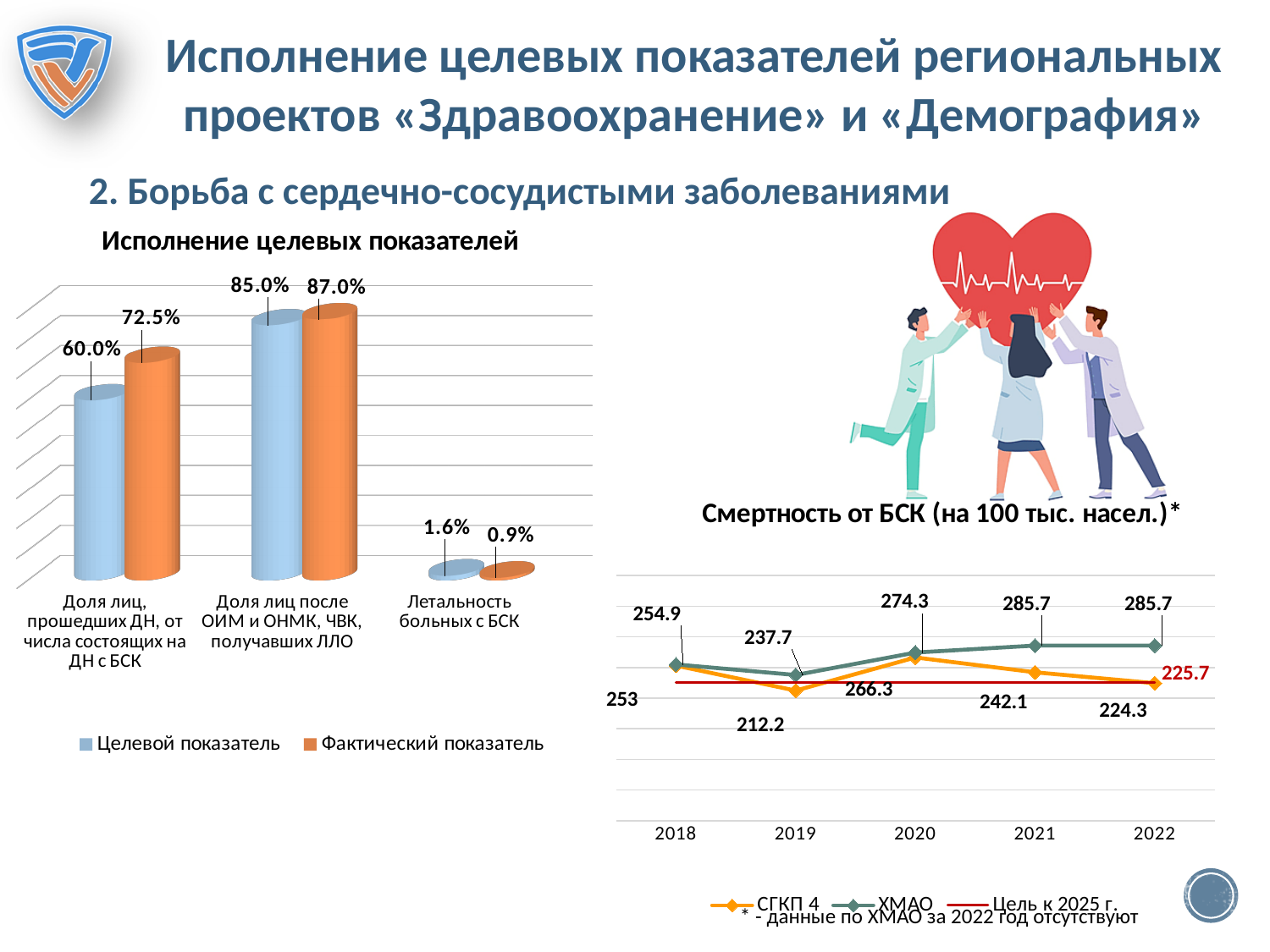
In the 'Смертность от БСК' chart, what is the value for СГКП 4 in 2022? 224.3 In the 'Смертность от БСК' chart, in which year is the СГКП 4 value lowest? 2019 In the 'Исполнение целевых показателей' chart, what is the target value (Целевой показатель) for 'Летальность больных с БСК'? 1.6% In the 'Смертность от БСК' chart, what is the value of the 'Цель к 2025 г.' line? 225.7 In the 'Исполнение целевых показателей' chart, what is the actual value (Фактический показатель) for 'Доля лиц, прошедших ДН, от числа состоящих на ДН с БСК'? 72.5% How many categories are shown in the 'Исполнение целевых показателей' chart? 3 What kind of chart is the 'Исполнение целевых показателей' chart on the left? Bar chart In the 'Смертность от БСК' chart, what is the value for ХМАО in 2021? 285.7 In the 'Исполнение целевых показателей' chart, by how much does the actual value exceed the target for 'Доля лиц, прошедших ДН, от числа состоящих на ДН с БСК'? 12.5% In the 'Исполнение целевых показателей' chart, which category has the highest actual value (Фактический показатель)? Доля лиц после ОИМ и ОНМК, ЧВК, получавших ЛЛО How many series does the legend of the 'Исполнение целевых показателей' chart list? 2 What kind of chart is the 'Смертность от БСК (на 100 тыс. насел.)' chart? Line chart